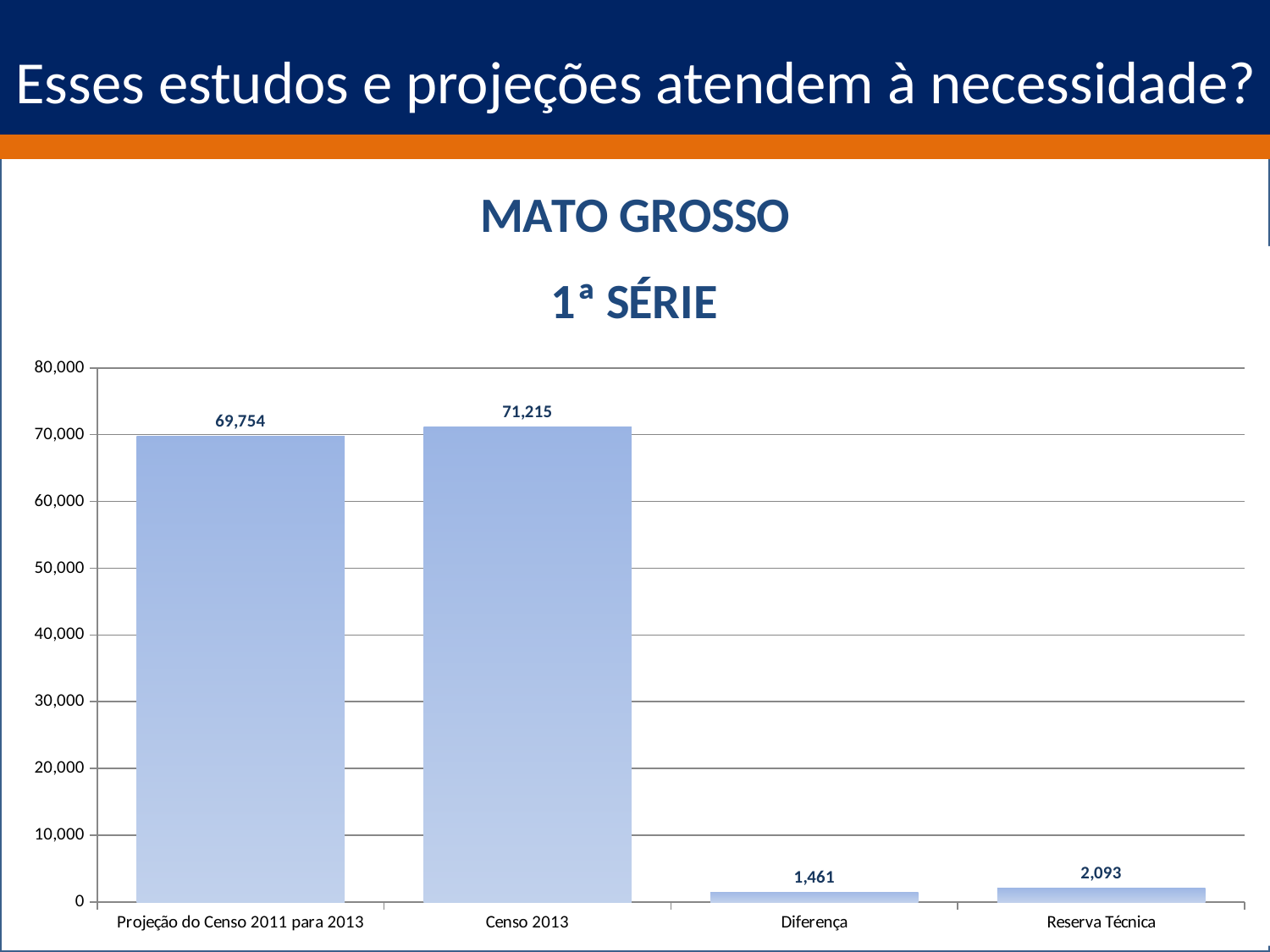
Which category has the lowest value? Diferença What is the difference between Reserva Técnica and Diferença? 632 What is the value for Censo 2013? 71,215 What kind of chart is shown on the slide? bar chart What is the value for Diferença? 1,461 Which category has the highest value? Censo 2013 Which is larger, Reserva Técnica or Diferença? Reserva Técnica What is the difference between Censo 2013 and Projeção do Censo 2011 para 2013? 1,461 What is the value for Projeção do Censo 2011 para 2013? 69,754 How many categories are shown on the x axis? 4 What is the value for Reserva Técnica? 2,093 Is the value for Censo 2013 greater or less than 70,000? greater